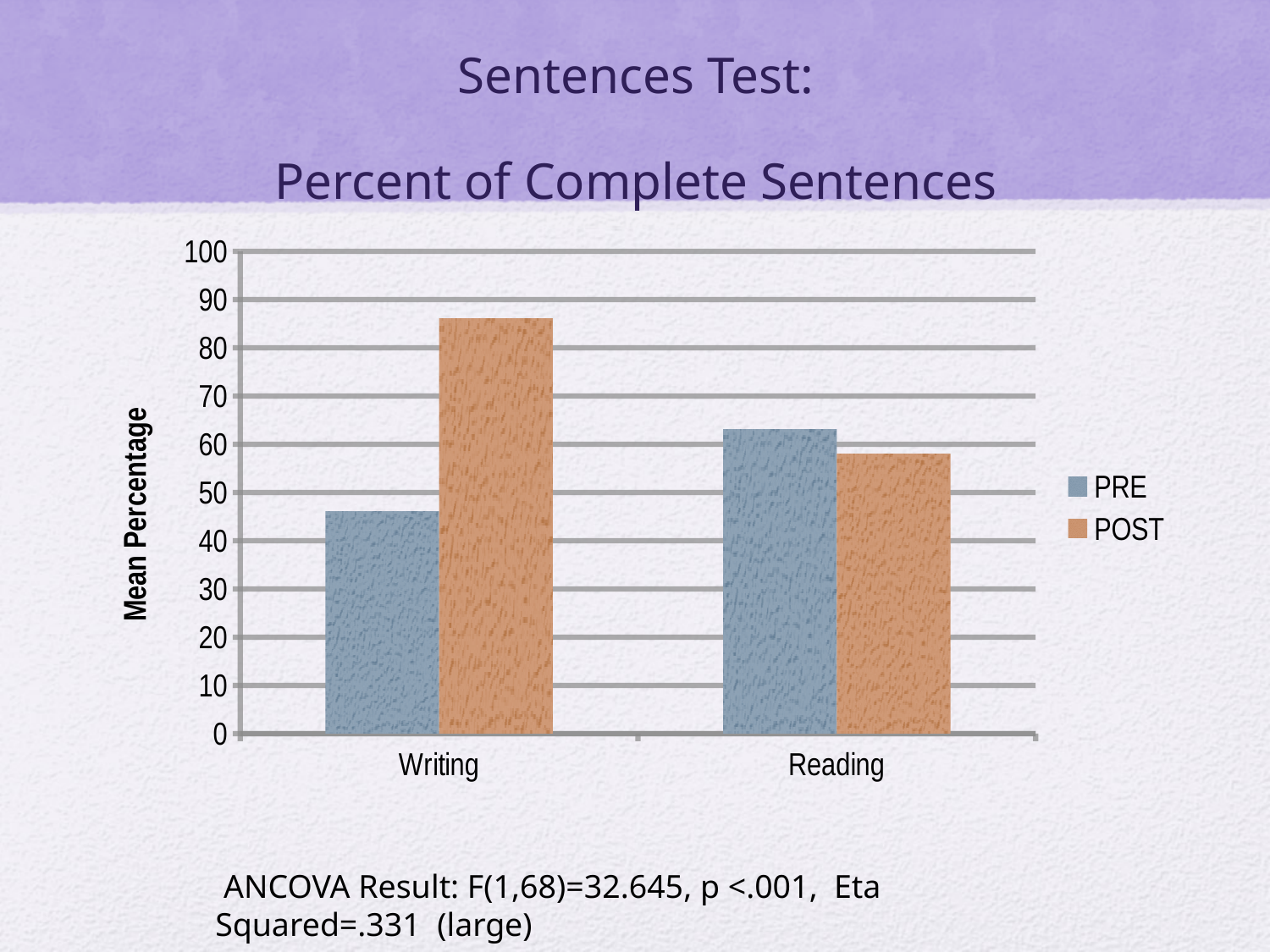
Which series is shown in orange? POST Which bar is the tallest in the chart? POST for Writing Is the POST value for Writing greater or less than 80? greater Is the POST value for Reading greater or less than 50? greater How many categories are shown on the x axis? 2 What kind of chart is shown on the slide? bar chart Which bar is the shortest in the chart? PRE for Writing For Writing, which is larger, PRE or POST? POST How many series does the legend list? 2 Is the PRE value for Writing greater or less than 50? less What is the label of the y axis? Mean Percentage For Reading, which is larger, PRE or POST? PRE